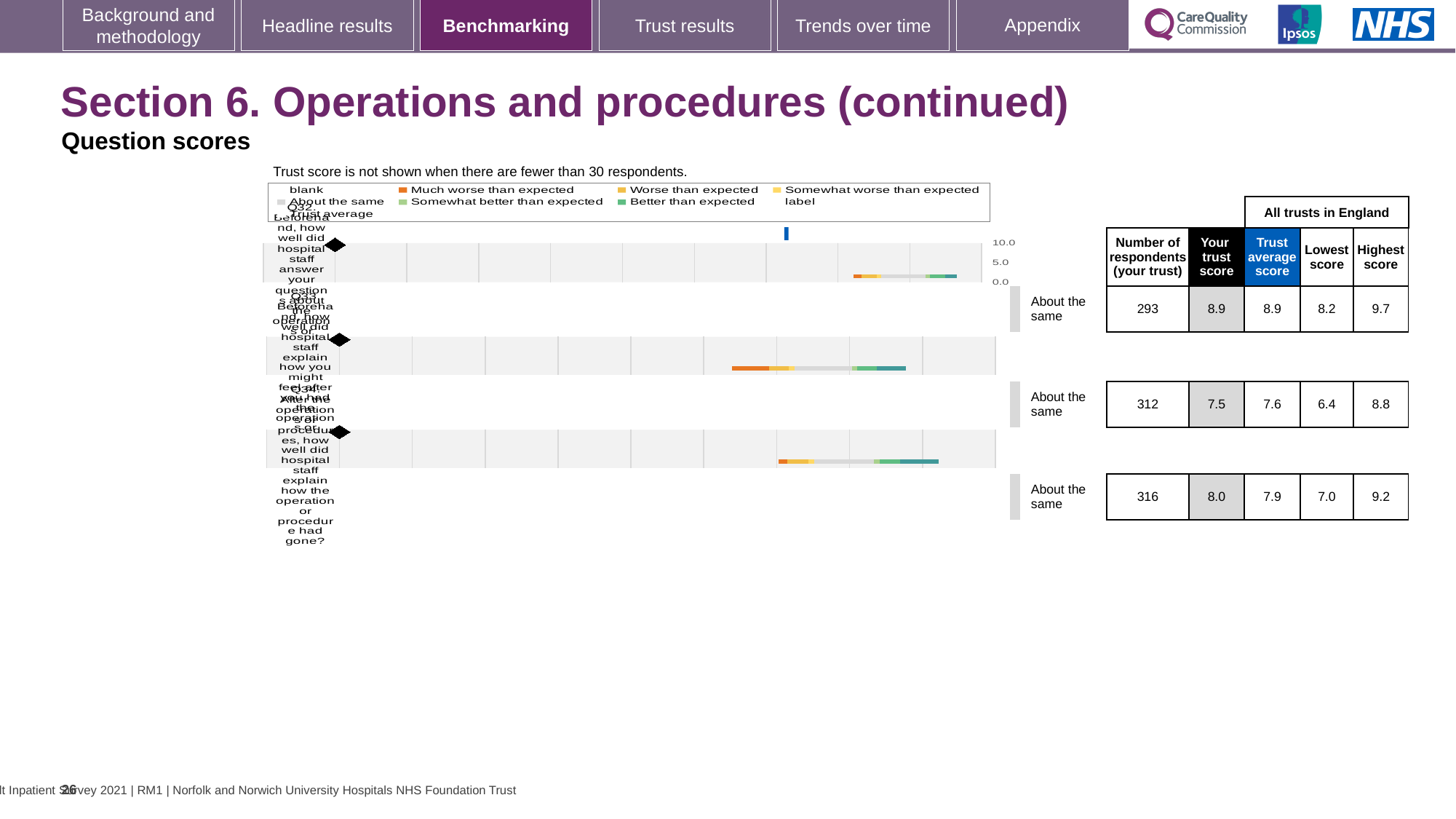
What is the 'Trust average score' for the second row (312 respondents)? 7.6 What is the difference between the highest score and the lowest score for the first row? 1.5 What is the 'Your trust score' for the first row (293 respondents)? 8.9 What kind of chart is used to show the question scores on this slide? bar chart What benchmark category is shown next to each of the three rows? About the same Which row has the highest 'Your trust score'? the first row (8.9) Which row has the lowest 'Lowest score' across all trusts in England? the second row (6.4) What is the 'Highest score' for the third row (316 respondents)? 9.2 What does the blue marker in the legend represent? Trust average What is the number of respondents for the third row? 316 For the third row, which is larger: 'Your trust score' or 'Trust average score'? Your trust score (8.0) How many questions (rows) are plotted in the chart? 3